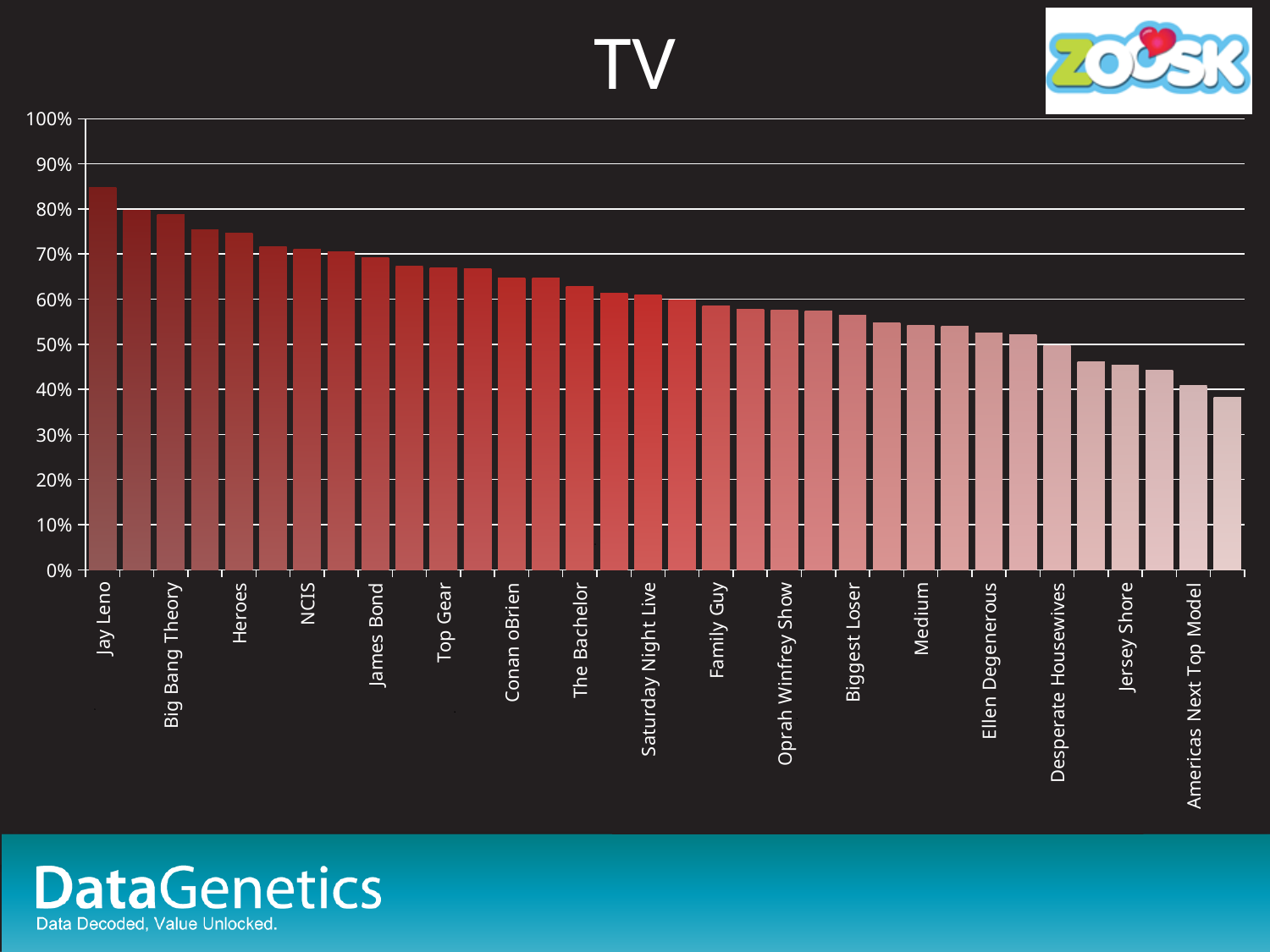
Do the values rise or fall moving from left to right along the x axis? fall Which labeled category has the highest value? Jay Leno Is the value for Americas Next Top Model greater or less than 50%? less Which has the larger value, Jay Leno or Americas Next Top Model? Jay Leno What is the title of the chart? TV Is the value for Family Guy greater or less than 60%? less Is the value for Jay Leno greater or less than 80%? greater Which has the larger value, Heroes or Jersey Shore? Heroes What kind of chart is shown on the slide? bar chart